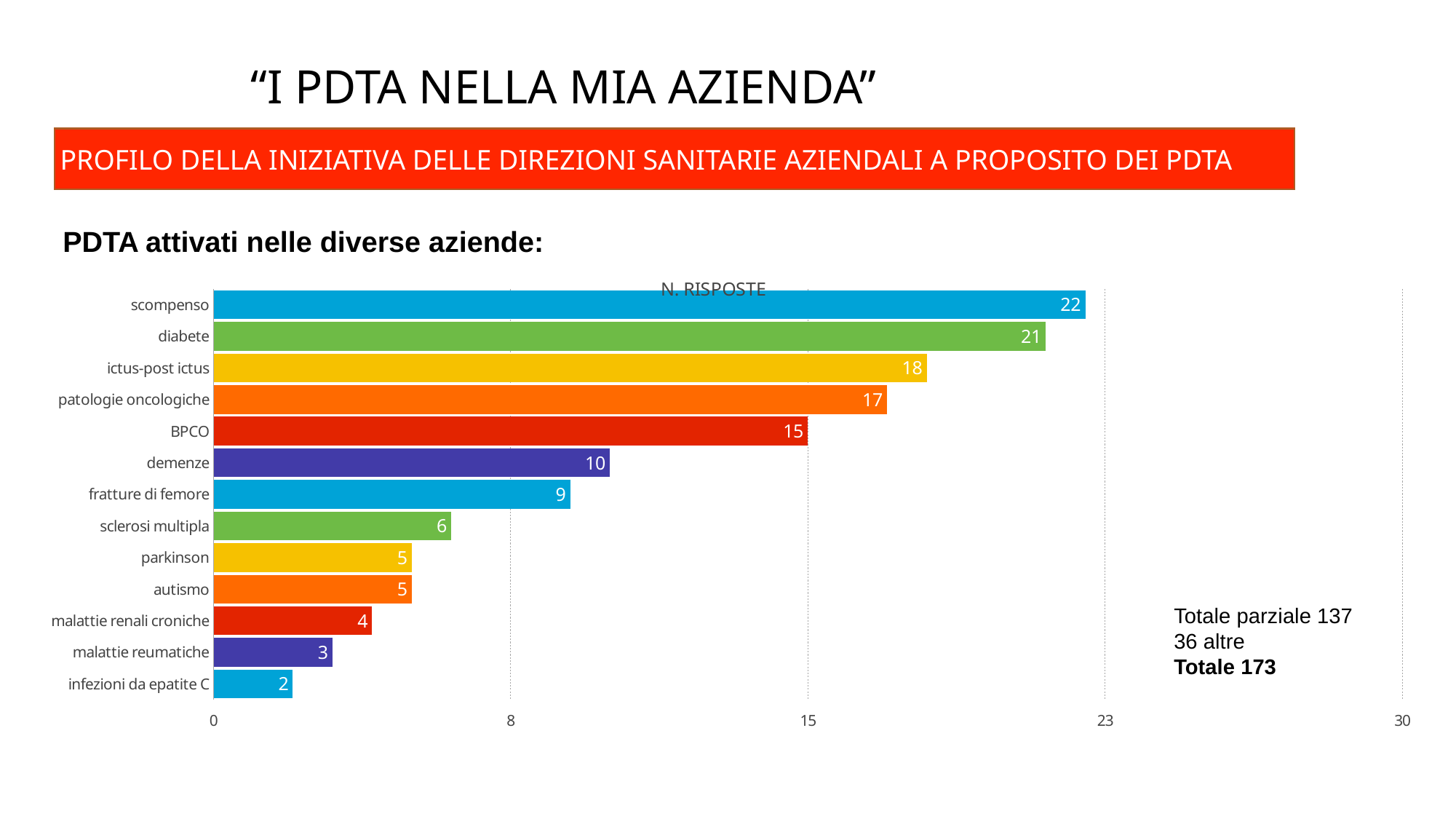
What kind of chart is shown on the slide? bar chart What is the title of the chart? N. RISPOSTE What is the value for BPCO? 15 Which category has the lowest value? infezioni da epatite C Is the value for patologie oncologiche greater or less than 15? greater Which category has the highest value? scompenso What is the value for fratture di femore? 9 What is the difference between the values for diabete and ictus-post ictus? 3 What is the value for malattie renali croniche? 4 How many categories are shown in the chart? 13 Which is larger, the value for demenze or the value for sclerosi multipla? demenze What is the value for scompenso? 22